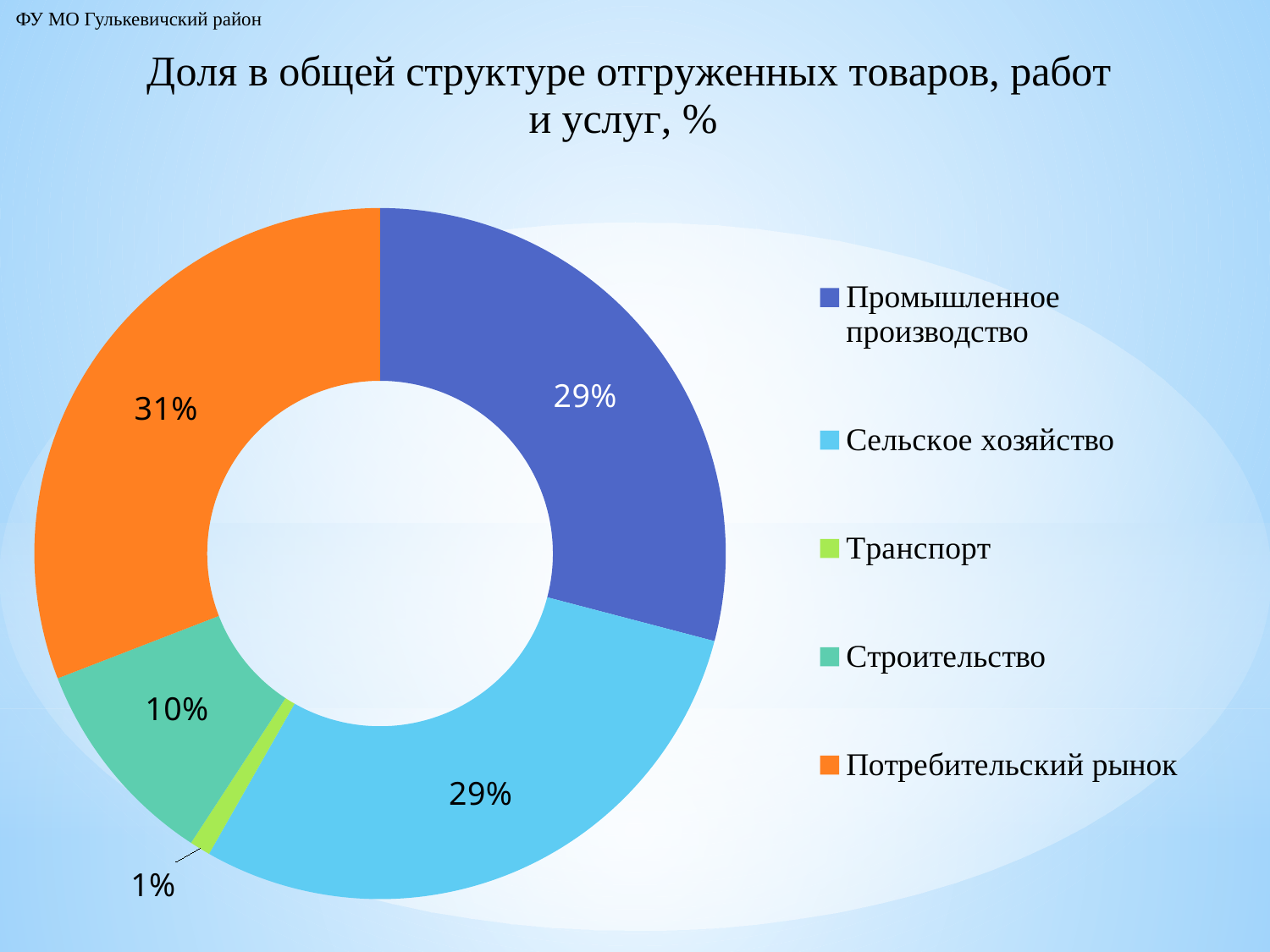
What share does Сельское хозяйство have in the chart? 29% What share does Транспорт have in the chart? 1% Which category has the largest share in the chart? Потребительский рынок What colour represents Потребительский рынок in the chart? Orange Which has a larger share, Строительство or Транспорт? Строительство What is the difference in percentage points between Потребительский рынок and Строительство? 21 What share does Строительство have in the chart? 10% What type of chart is shown on the slide? Doughnut (pie) chart What share does Потребительский рынок have in the chart? 31% How many categories are shown in the chart? 5 Which category has the smallest share in the chart? Транспорт What share does Промышленное производство have in the chart? 29%